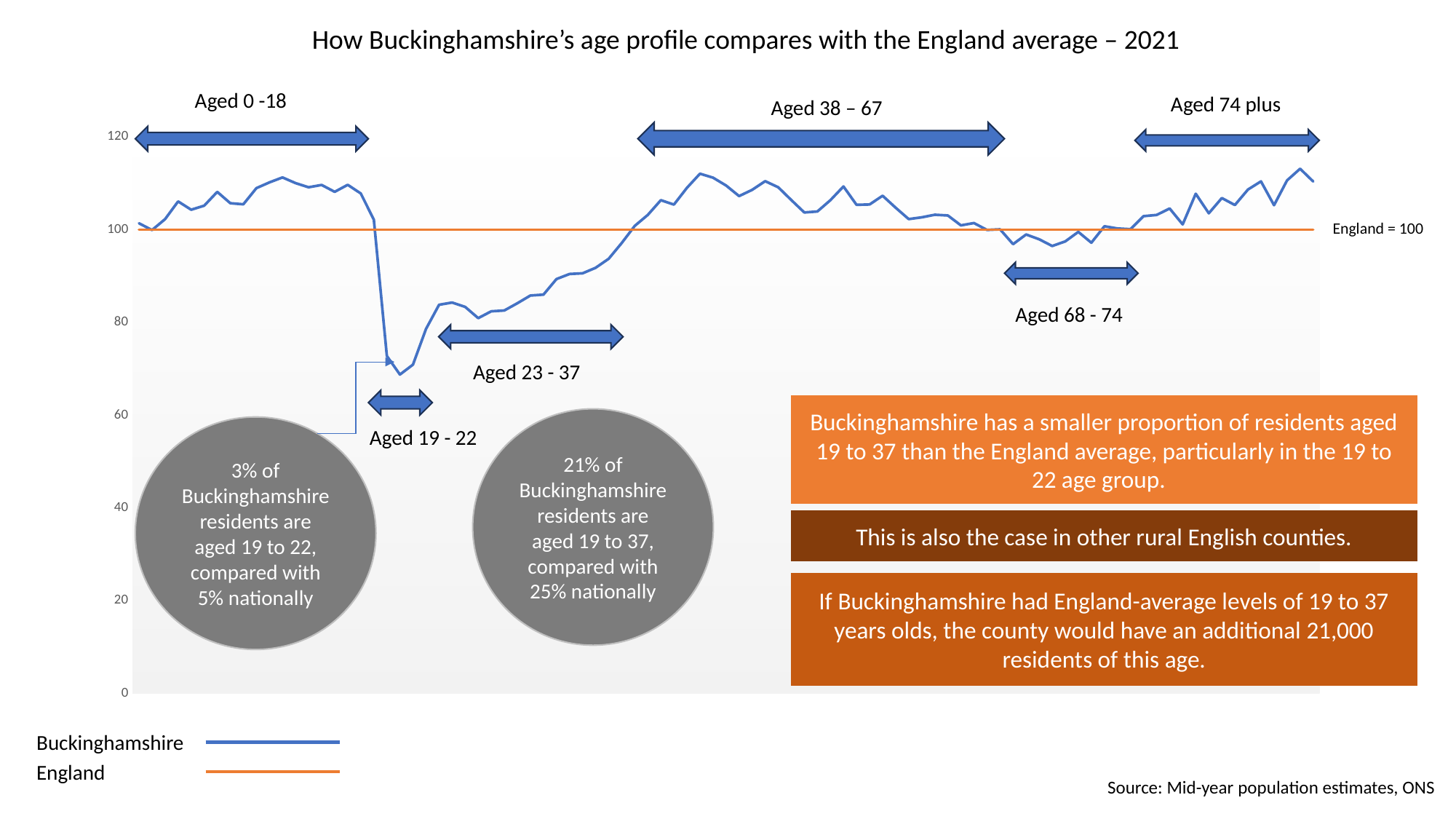
What kind of chart is shown on the slide? line chart Is the Buckinghamshire value for the aged 19 - 22 group greater or less than 80? less Which labelled age group has the lowest Buckinghamshire value? Aged 19 - 22 Does the Buckinghamshire line rise or fall from the aged 19 - 22 group to the aged 23 - 37 group? rise Is the Buckinghamshire value for the aged 23 - 37 group greater or less than the England value of 100? less Which series is drawn in blue? Buckinghamshire How many age groups are labelled with arrows on the chart? 6 Is the Buckinghamshire value for the aged 0 -18 group greater or less than 100? greater Is the Buckinghamshire value for the aged 74 plus group greater or less than 100? greater What is the title of the chart? How Buckinghamshire's age profile compares with the England average – 2021 How many series does the legend list? 2 What value does the orange England line represent? 100